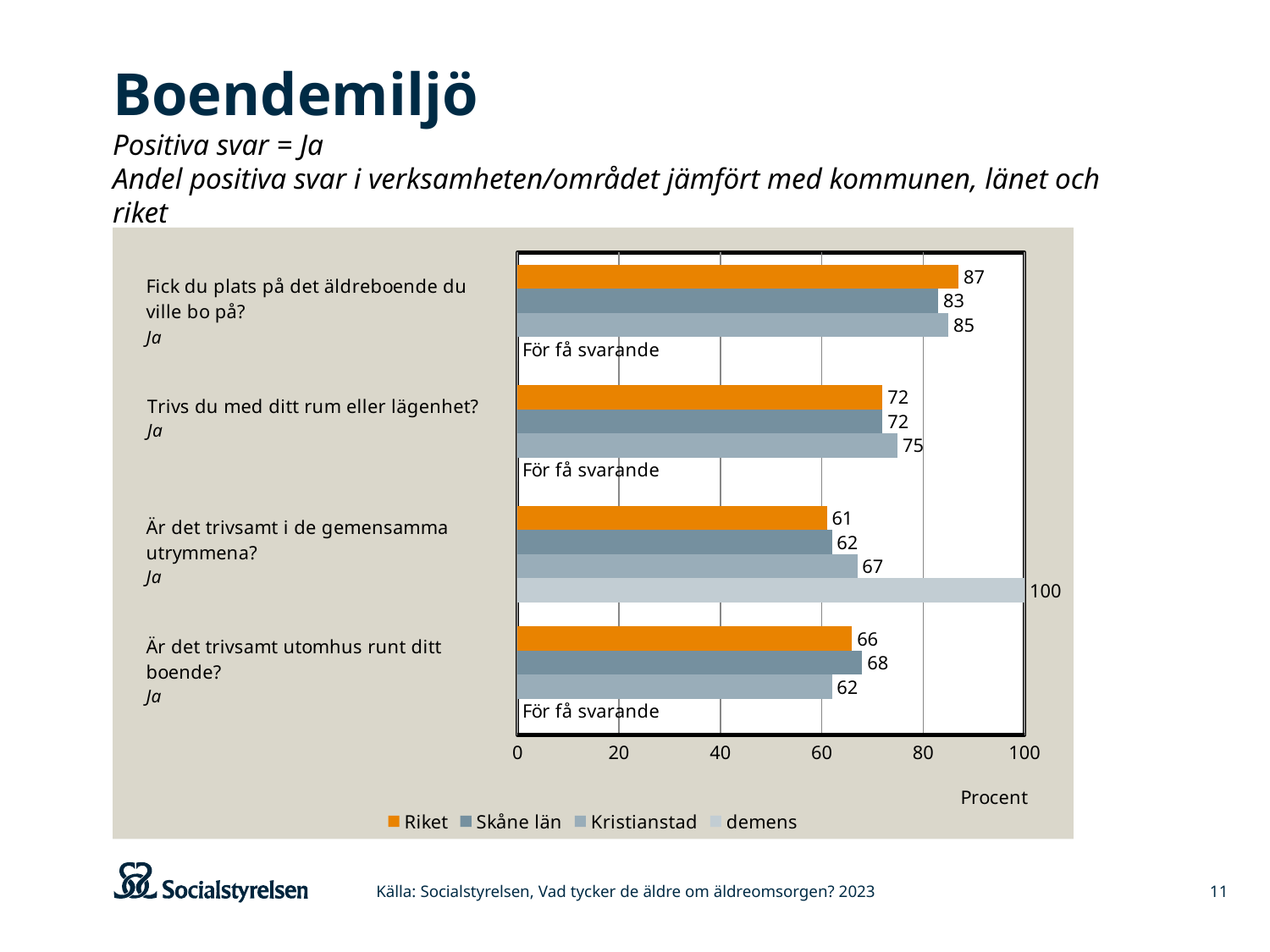
Which series has the highest value on the question "Fick du plats på det äldreboende du ville bo på?"? Riket What is the value for Skåne län on the question "Är det trivsamt utomhus runt ditt boende?"? 68 What kind of chart is shown on the slide? Bar chart On the question "Fick du plats på det äldreboende du ville bo på?", which is larger: the Skåne län value or the Kristianstad value? Kristianstad What is the value for Kristianstad on the question "Trivs du med ditt rum eller lägenhet?"? 75 What is the value for Riket on the question "Fick du plats på det äldreboende du ville bo på?"? 87 How many questions (categories) are shown on the chart? 4 What is the difference between the Kristianstad value and the Riket value on the question "Är det trivsamt i de gemensamma utrymmena?"? 6 Which series has the lowest value on the question "Är det trivsamt utomhus runt ditt boende?"? Kristianstad How many series does the legend list? 4 What text is shown in place of the demens bar on the question "Trivs du med ditt rum eller lägenhet?"? För få svarande What is the value for demens on the question "Är det trivsamt i de gemensamma utrymmena?"? 100